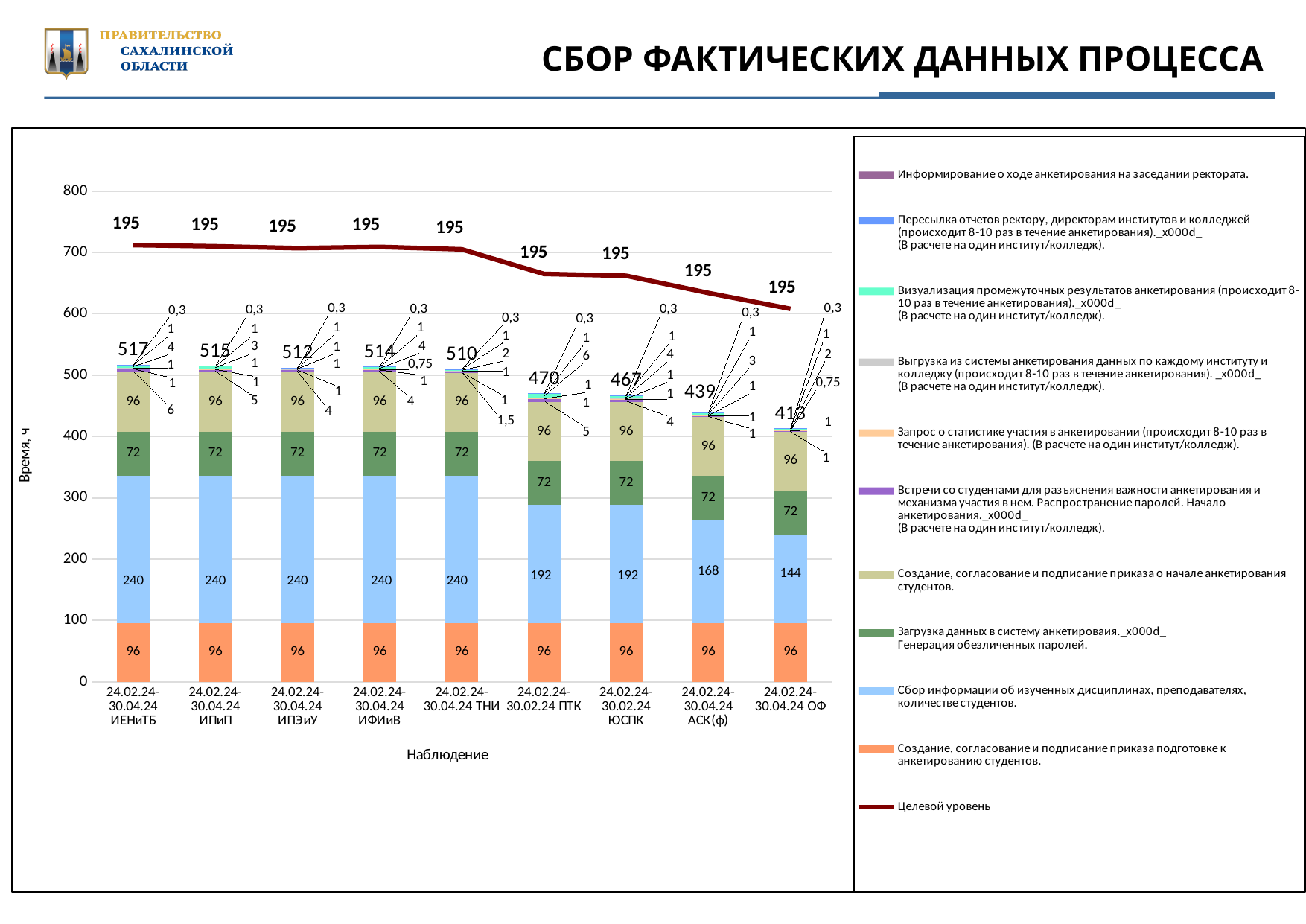
How many observation categories are shown on the x axis? 9 Which observation has the highest total bar value? 24.02.24-30.04.24 ИЕНиТБ Which has the larger total bar value: 24.02.24-30.02.24 ПТК or 24.02.24-30.02.24 ЮСПК? 24.02.24-30.02.24 ПТК What is the total value labeled above the bar for 24.02.24-30.04.24 ОФ? 413 How many entries does the legend list? 11 Do the total bar values rise or fall moving from left to right along the x axis? fall Which observation has the lowest total bar value? 24.02.24-30.04.24 ОФ What is the difference between the total for ИЕНиТБ (517) and the total for ОФ (413)? 104 What is the title of the y axis? Время, ч What is the value of the light blue segment (Сбор информации об изученных дисциплинах, преподавателях, количестве студентов) for 24.02.24-30.04.24 АСК(ф)? 168 What kind of chart is shown on the slide? stacked bar chart with a line What value is labeled on the Целевой уровень line for each observation? 195